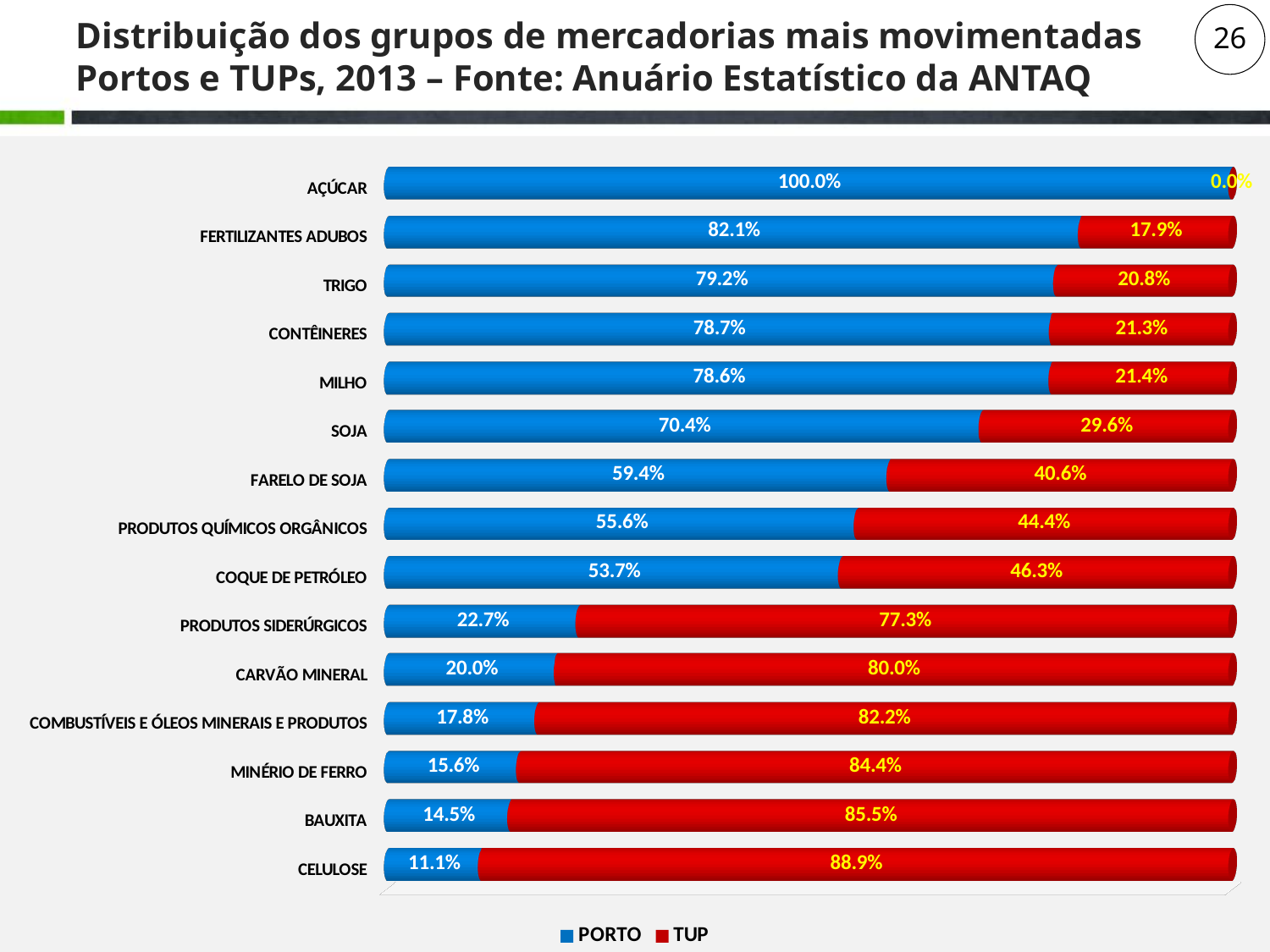
Which colour represents TUP in the chart? Red How many commodity groups are shown in the chart? 15 What is the TUP share for MINÉRIO DE FERRO? 84.4% Which category has the lowest PORTO share? CELULOSE What is the PORTO share for SOJA? 70.4% What is the difference between the TUP share and the PORTO share for CARVÃO MINERAL? 60.0% How many series does the legend list? 2 Which category has the highest PORTO share? AÇÚCAR Which is larger for FARELO DE SOJA, the PORTO share or the TUP share? PORTO What kind of chart is shown on the slide? Stacked bar chart What is the TUP share for CONTÊINERES? 21.3% Which category has the highest TUP share? CELULOSE